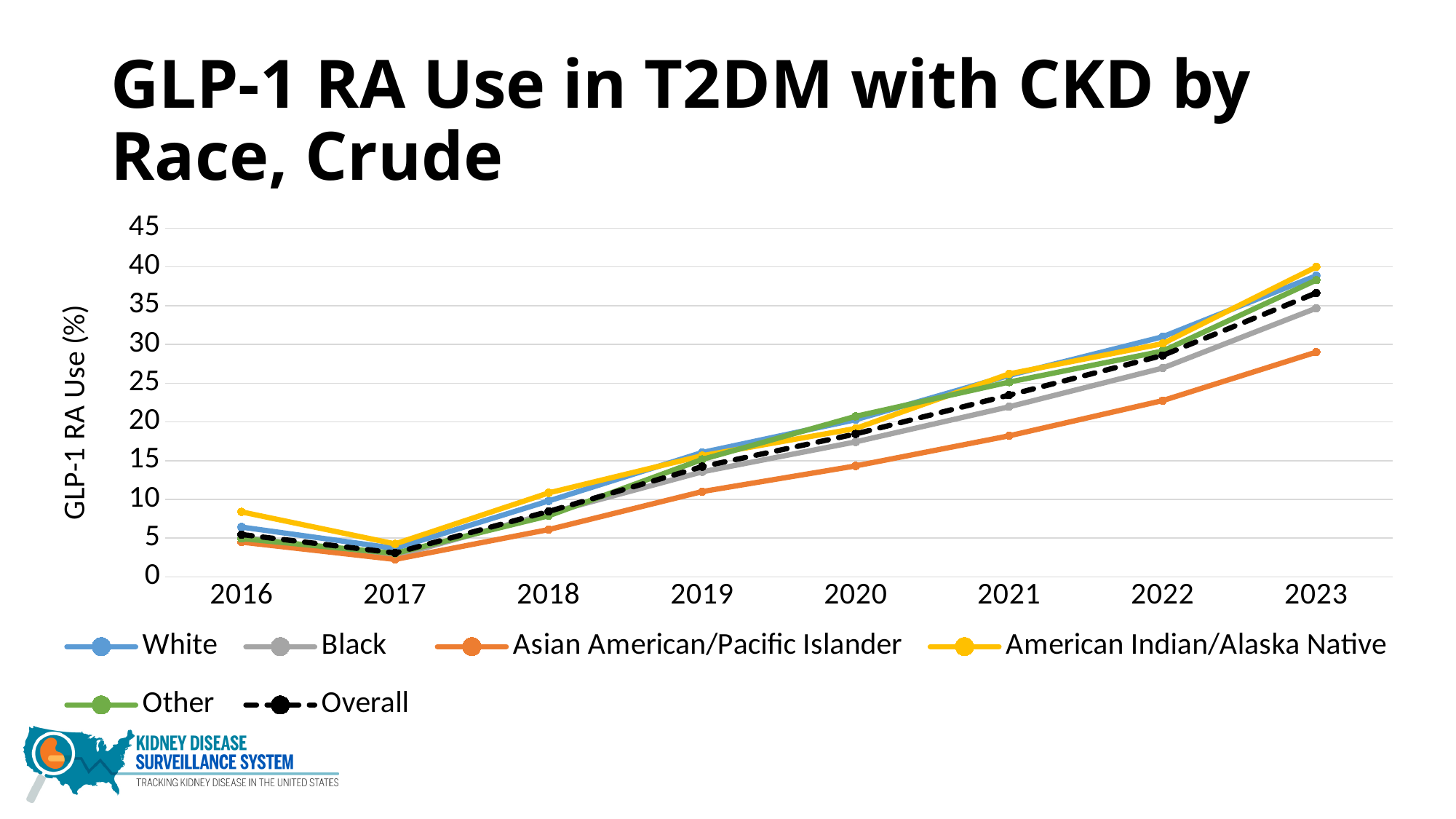
Is the value for Black in 2023 greater or less than 30? greater How many series does the legend list? 6 What kind of chart is shown on the slide? line chart Is the value for Asian American/Pacific Islander in 2023 greater or less than 35? less Which series has the highest GLP-1 RA use in 2023? American Indian/Alaska Native How many years are plotted along the x axis? 8 Which series is drawn with a dashed line? Overall In 2022, which is larger: the value for White or the value for Asian American/Pacific Islander? White Is the value for American Indian/Alaska Native in 2016 greater or less than 5? greater From 2017 to 2023, do the values for the Overall series rise or fall? rise In which year is the Overall series at its lowest value? 2017 Which series has the lowest GLP-1 RA use in 2023? Asian American/Pacific Islander